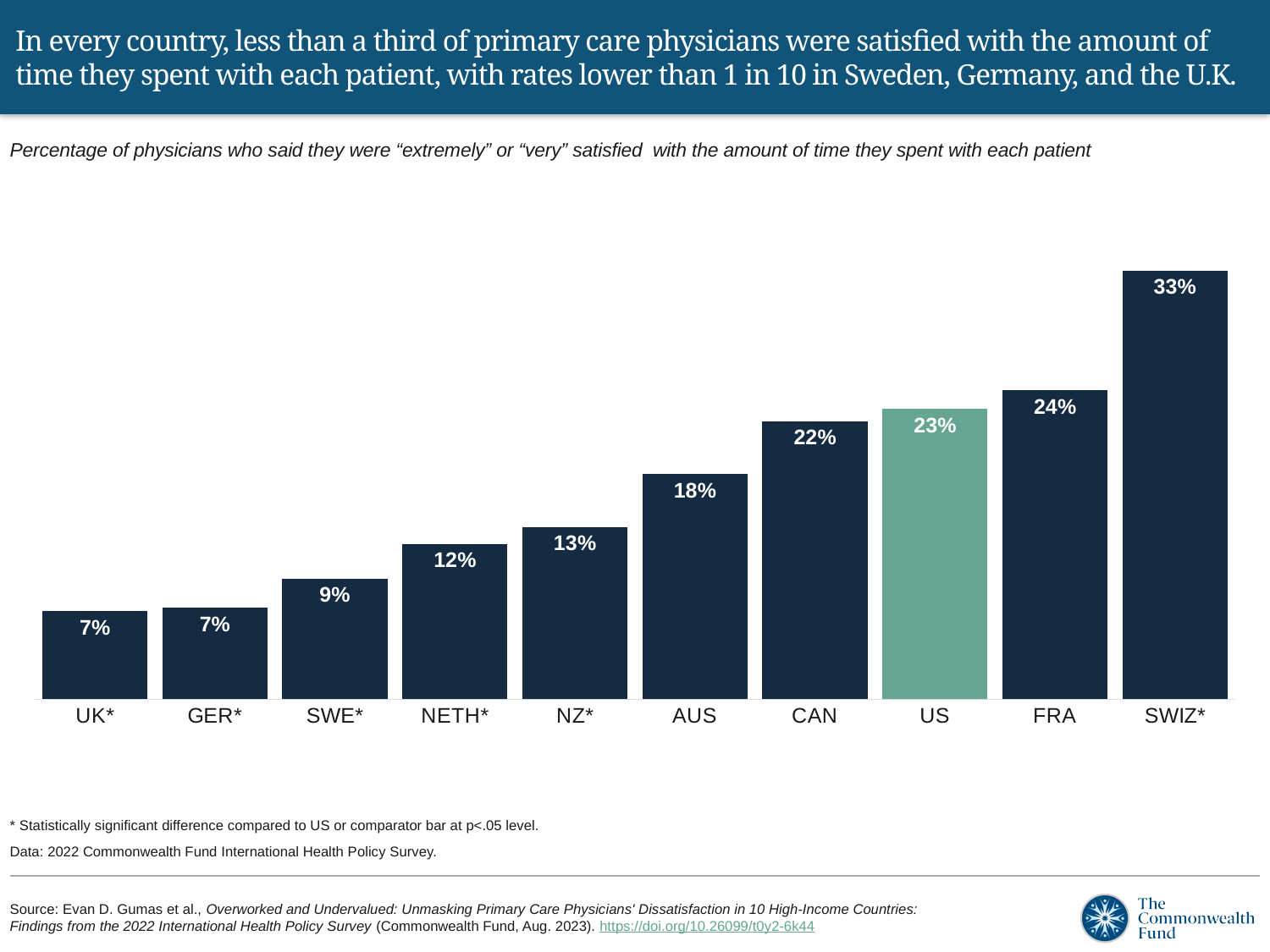
What percentage of physicians in the US said they were extremely or very satisfied with the amount of time spent with each patient? 23% What type of chart is shown on the slide? Bar chart Do the values rise or fall moving from left to right across the chart? Rise Which bar is shown in a different colour (green) from the others? US Which has a higher value, CAN or NZ*? CAN How many countries are shown in the chart? 10 Which country has the lowest value, SWE*, NZ*, or CAN? SWE* What is the difference between the values for SWIZ* and FRA? 9 percentage points What is the difference between the values for US and UK*? 16 percentage points What is the value shown for AUS? 18% Which country has the highest percentage of satisfied physicians? SWIZ* What is the value shown for NETH*? 12%